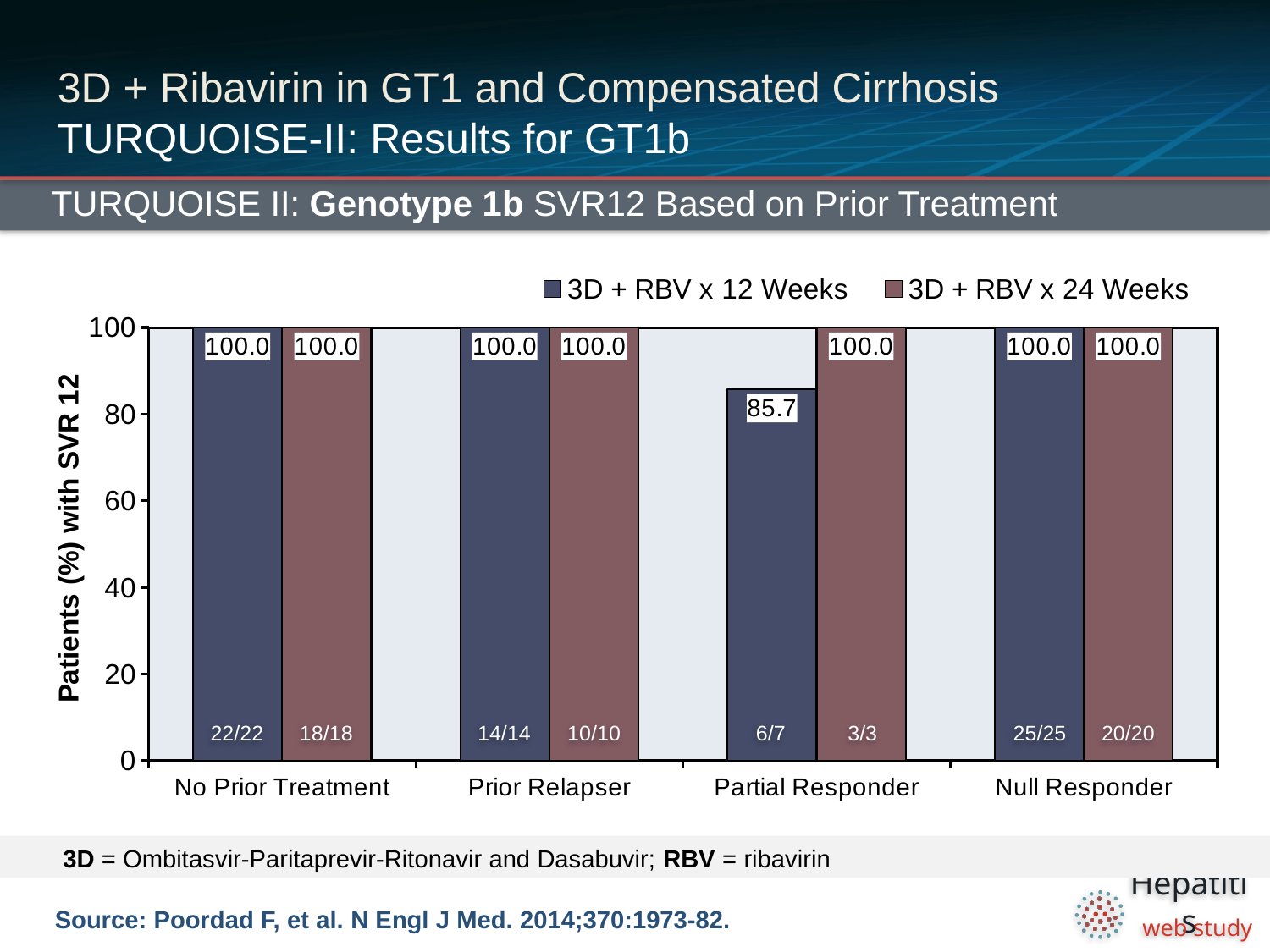
Is the value for 3D + RBV x 12 Weeks in the Partial Responder category greater or less than 80? greater What kind of chart is shown on the slide? Bar chart How many prior treatment categories are shown on the x axis? 4 What is the difference between the 3D + RBV x 24 Weeks and 3D + RBV x 12 Weeks values in the Partial Responder category? 14.3 What fraction of patients is shown for the 3D + RBV x 24 Weeks bar in the Prior Relapser category? 10/10 In the Partial Responder category, which series has the larger value, 3D + RBV x 12 Weeks or 3D + RBV x 24 Weeks? 3D + RBV x 24 Weeks What is the SVR12 rate for the 3D + RBV x 24 Weeks series in the Null Responder category? 100.0 What is the SVR12 rate for the 3D + RBV x 12 Weeks series in the Partial Responder category? 85.7 What fraction of patients is shown for the 3D + RBV x 12 Weeks bar in the No Prior Treatment category? 22/22 What is the label of the y axis? Patients (%) with SVR 12 How many series does the legend list? 2 Which category has the lowest value for the 3D + RBV x 12 Weeks series? Partial Responder